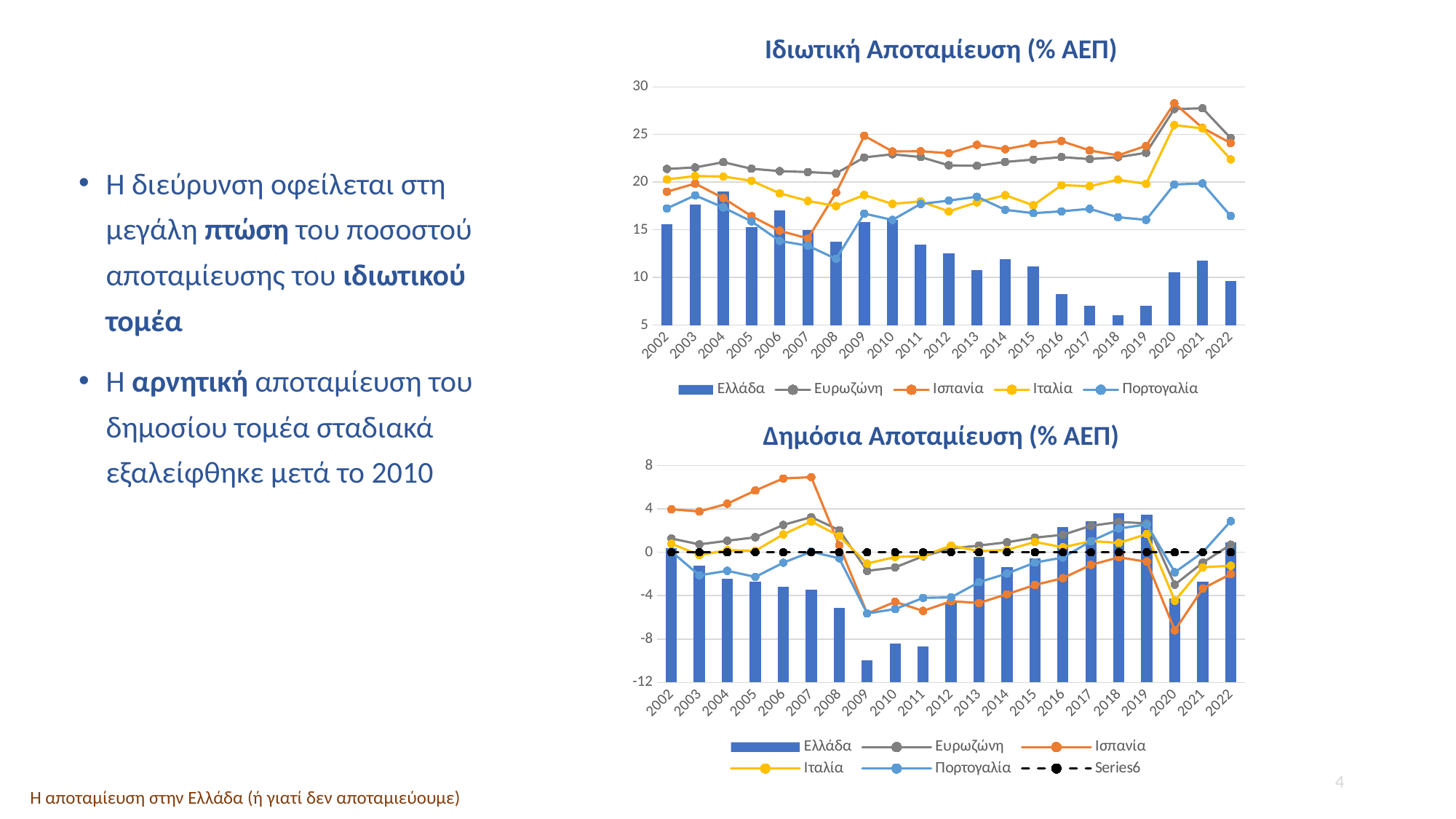
In the top chart 'Ιδιωτική Αποταμίευση (% ΑΕΠ)', in which year is the Ελλάδα bar lowest? 2018 In the bottom chart 'Δημόσια Αποταμίευση (% ΑΕΠ)', how many series does the legend list? 6 In the bottom chart 'Δημόσια Αποταμίευση (% ΑΕΠ)', in which year is the Ελλάδα bar lowest? 2009 In the top chart 'Ιδιωτική Αποταμίευση (% ΑΕΠ)', is the value for Ελλάδα in 2018 greater or less than 10? less In the top chart 'Ιδιωτική Αποταμίευση (% ΑΕΠ)', how many series does the legend list? 5 In the top chart 'Ιδιωτική Αποταμίευση (% ΑΕΠ)', which is larger in 2020: Ισπανία or Πορτογαλία? Ισπανία In the bottom chart 'Δημόσια Αποταμίευση (% ΑΕΠ)', what is the name of the dashed black series in the legend? Series6 In the bottom chart 'Δημόσια Αποταμίευση (% ΑΕΠ)', is the value for Ελλάδα in 2009 greater or less than -8? less What kind of chart is the top chart titled 'Ιδιωτική Αποταμίευση (% ΑΕΠ)'? A combined bar and line chart In the top chart 'Ιδιωτική Αποταμίευση (% ΑΕΠ)', how many years are shown on the x axis? 21 In the bottom chart 'Δημόσια Αποταμίευση (% ΑΕΠ)', do the Ισπανία values rise or fall from 2002 to 2007? rise In the top chart 'Ιδιωτική Αποταμίευση (% ΑΕΠ)', is the value for Ισπανία in 2020 greater or less than 25? greater